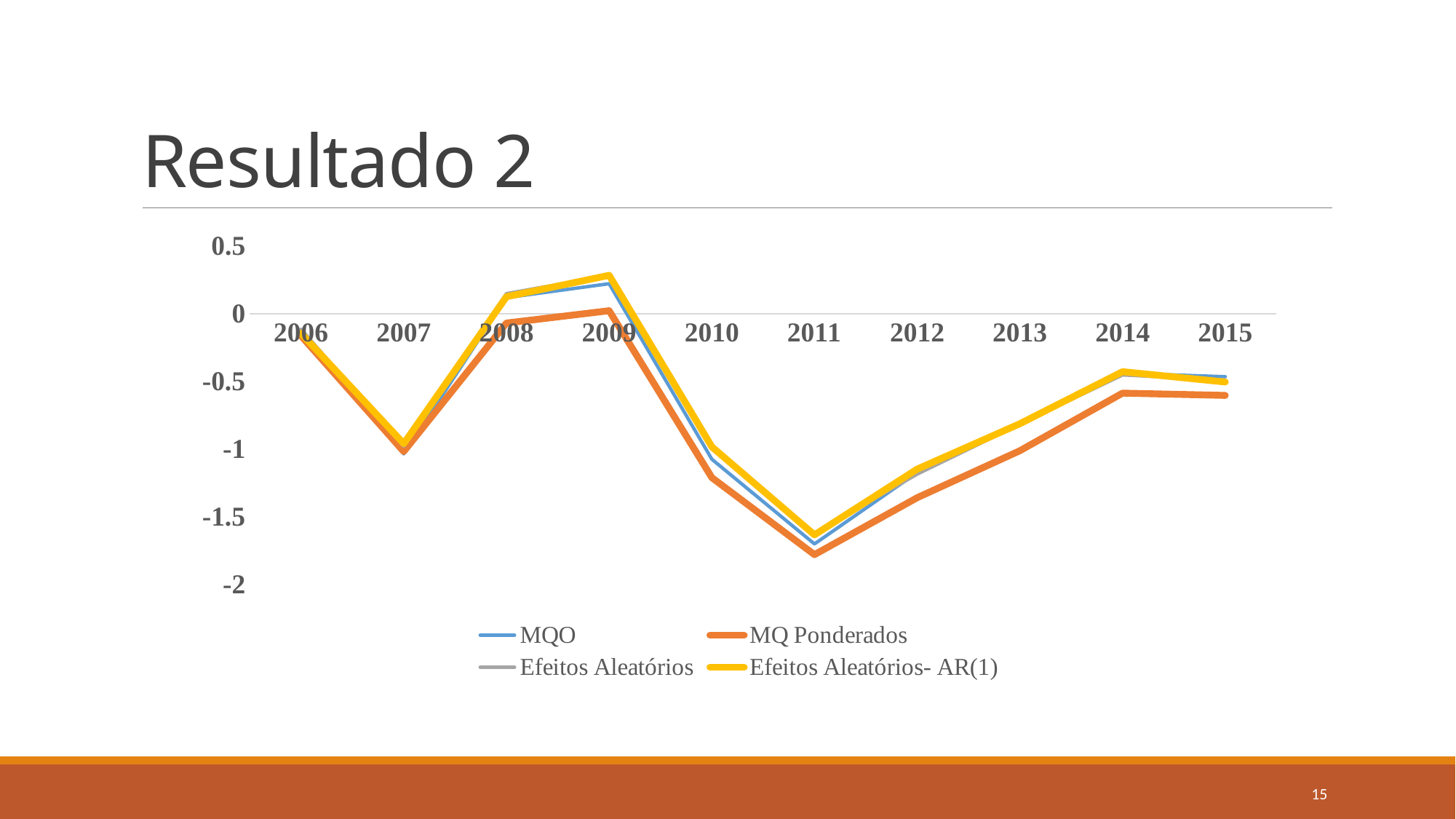
How many series does the legend list? 4 Is the value for MQ Ponderados in 2011 greater or less than -1.5? less What is the title of the slide containing the chart? Resultado 2 Is the value for MQ Ponderados in 2014 greater or less than -1? greater What kind of chart is shown on the slide? line chart Is the value for Efeitos Aleatórios- AR(1) in 2009 greater or less than 0? greater In which year does the Efeitos Aleatórios- AR(1) series reach its highest value? 2009 Do the series rise or fall between 2009 and 2011? fall In which year does the MQ Ponderados series reach its lowest value? 2011 How many years are shown on the x axis? 10 Do the series rise or fall between 2011 and 2014? rise